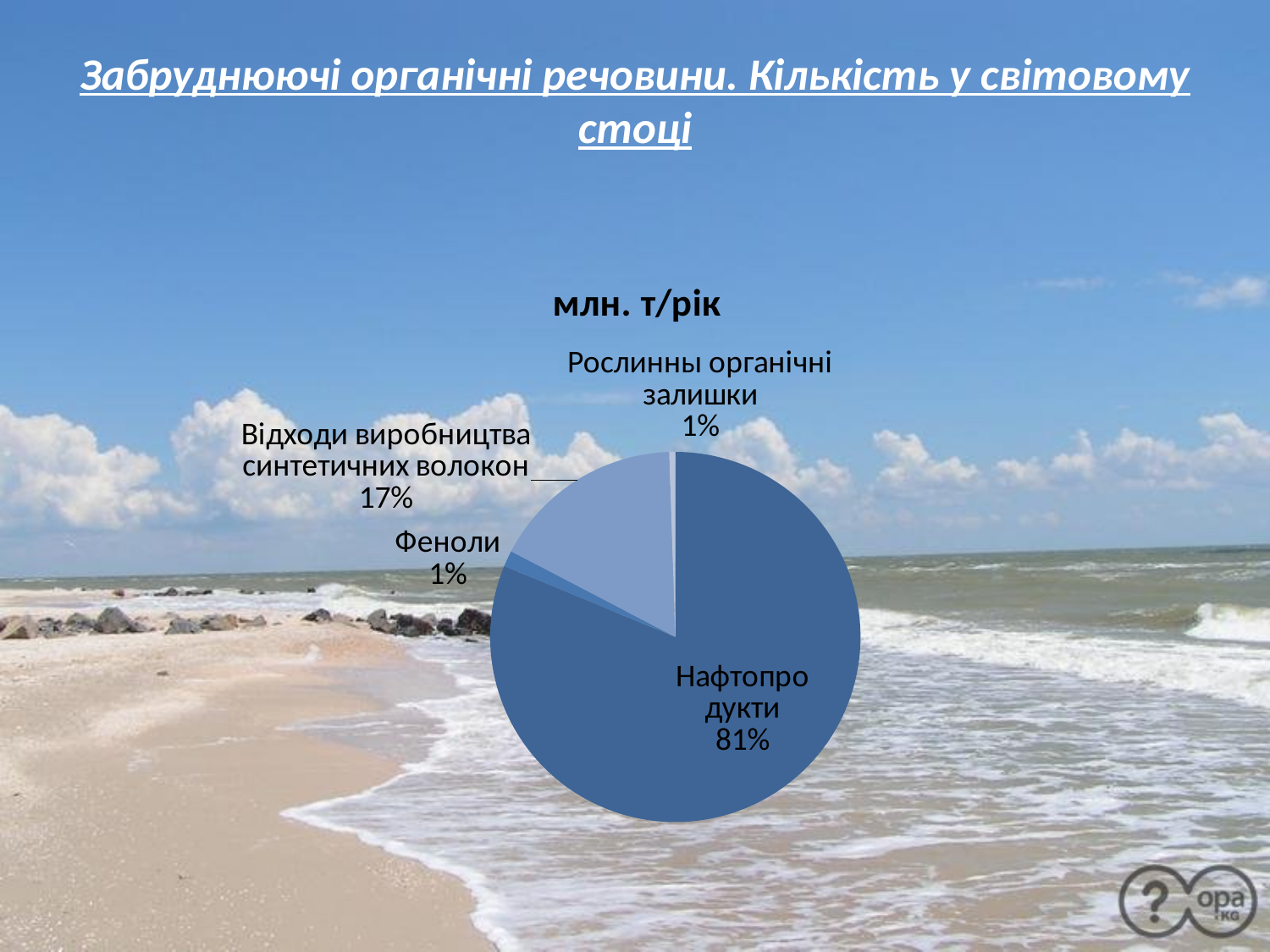
What share of the pie does Феноли have? 1% How many slices does the pie chart have? 4 What kind of chart is shown on the slide? pie chart Is the share for Нафтопродукти greater or less than 50%? greater What is the title of the chart? млн. т/рік What share of the pie does Відходи виробництва синтетичних волокон have? 17% Which category has the largest slice of the pie? Нафтопродукти What is the combined share of Феноли and Рослинны органічні залишки? 2% What share of the pie does Рослинны органічні залишки have? 1% What is the difference in percentage points between Нафтопродукти and Відходи виробництва синтетичних волокон? 64 Which is larger, the slice for Відходи виробництва синтетичних волокон or the slice for Феноли? Відходи виробництва синтетичних волокон